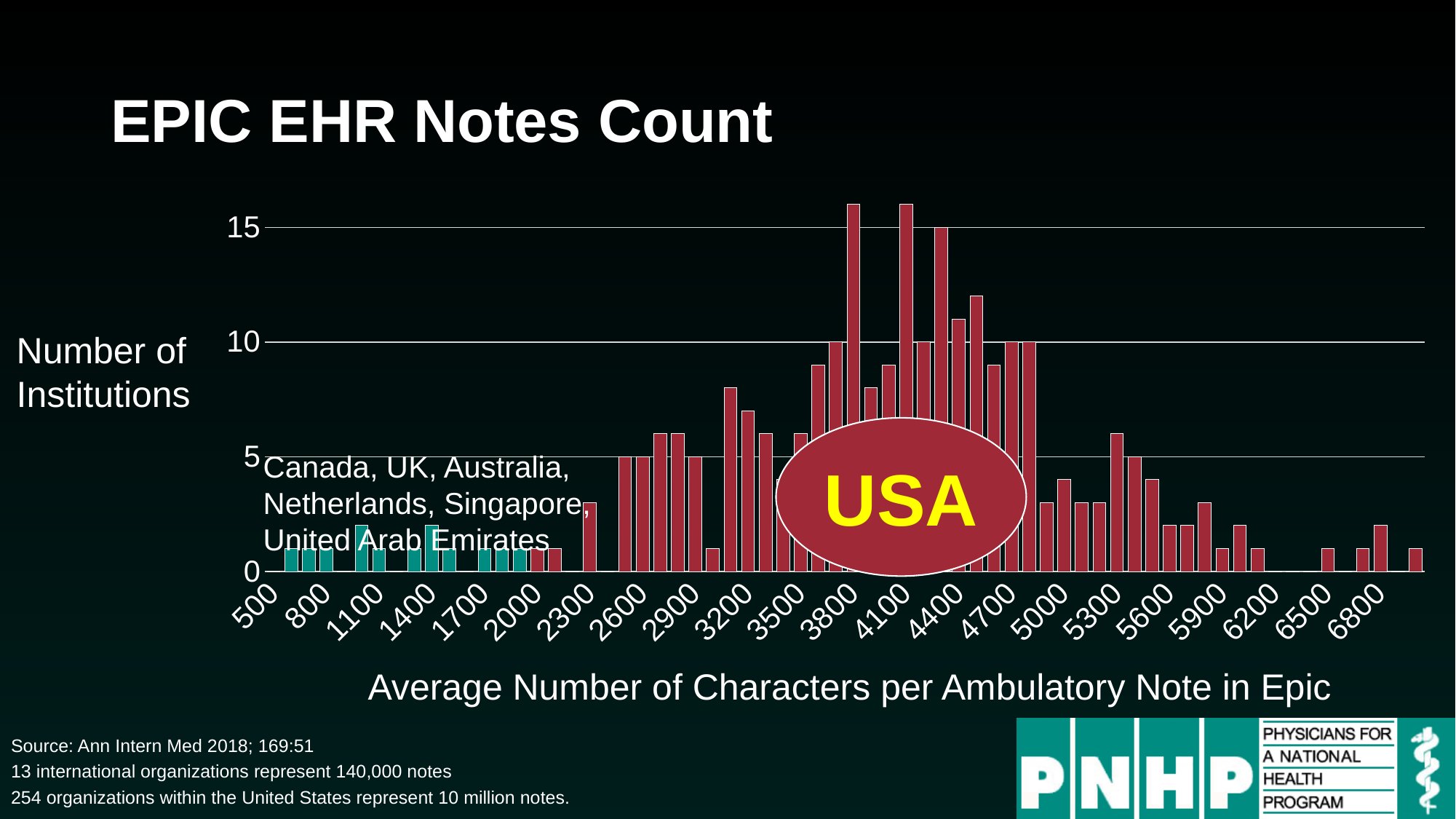
What is the title of the chart? EPIC EHR Notes Count Which group of institutions, the USA or the international group, has the tallest bars? USA How many labelled tick marks are on the horizontal axis? 22 Are the teal bars (Canada, UK, Australia, Netherlands, Singapore, United Arab Emirates) greater or less than 5? less What is the highest tick value shown on the vertical axis? 15 Is the tallest bar in the chart greater or less than 15? greater What kind of chart is shown on the slide? bar chart What is the highest tick value labelled on the horizontal axis? 6800 What does the vertical axis of the chart measure? Number of Institutions What is the lowest tick value labelled on the horizontal axis? 500